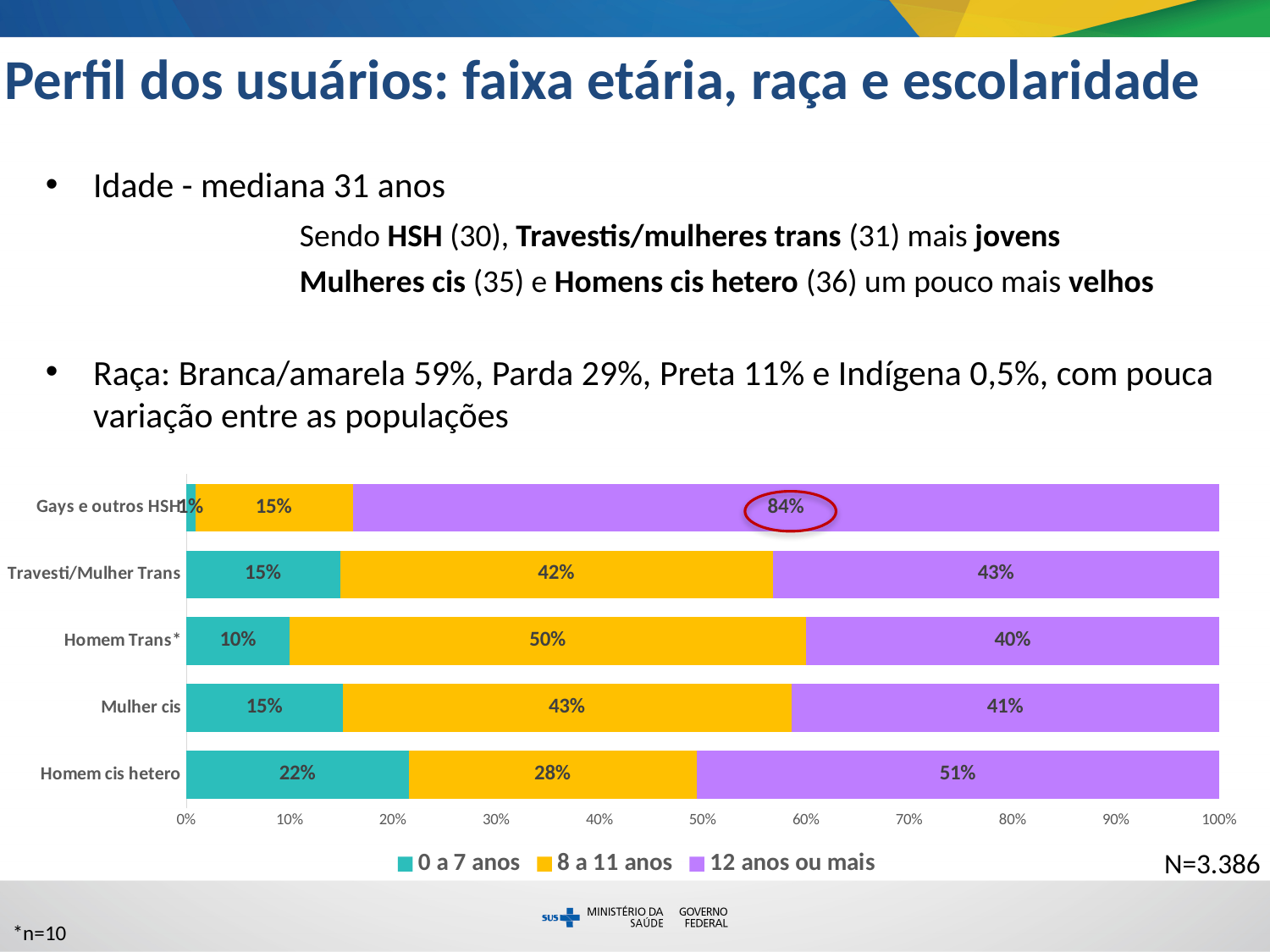
What is the value of '8 a 11 anos' for Homem Trans*? 50% What is the value of '12 anos ou mais' for Mulher cis? 41% What is the value of '12 anos ou mais' for Gays e outros HSH? 84% Which category has the lowest value for '8 a 11 anos'? Gays e outros HSH How many population categories are plotted in the chart? 5 Which is larger: the '8 a 11 anos' value for Travesti/Mulher Trans or for Homem cis hetero? Travesti/Mulher Trans What is the difference between the '12 anos ou mais' values for Homem cis hetero and Homem Trans*? 11% Which series in the legend is shown in purple? 12 anos ou mais What is the value of '0 a 7 anos' for Homem cis hetero? 22% What kind of chart is shown on the slide? Stacked bar chart Which category has the highest value for '12 anos ou mais'? Gays e outros HSH How many series does the chart legend list? 3